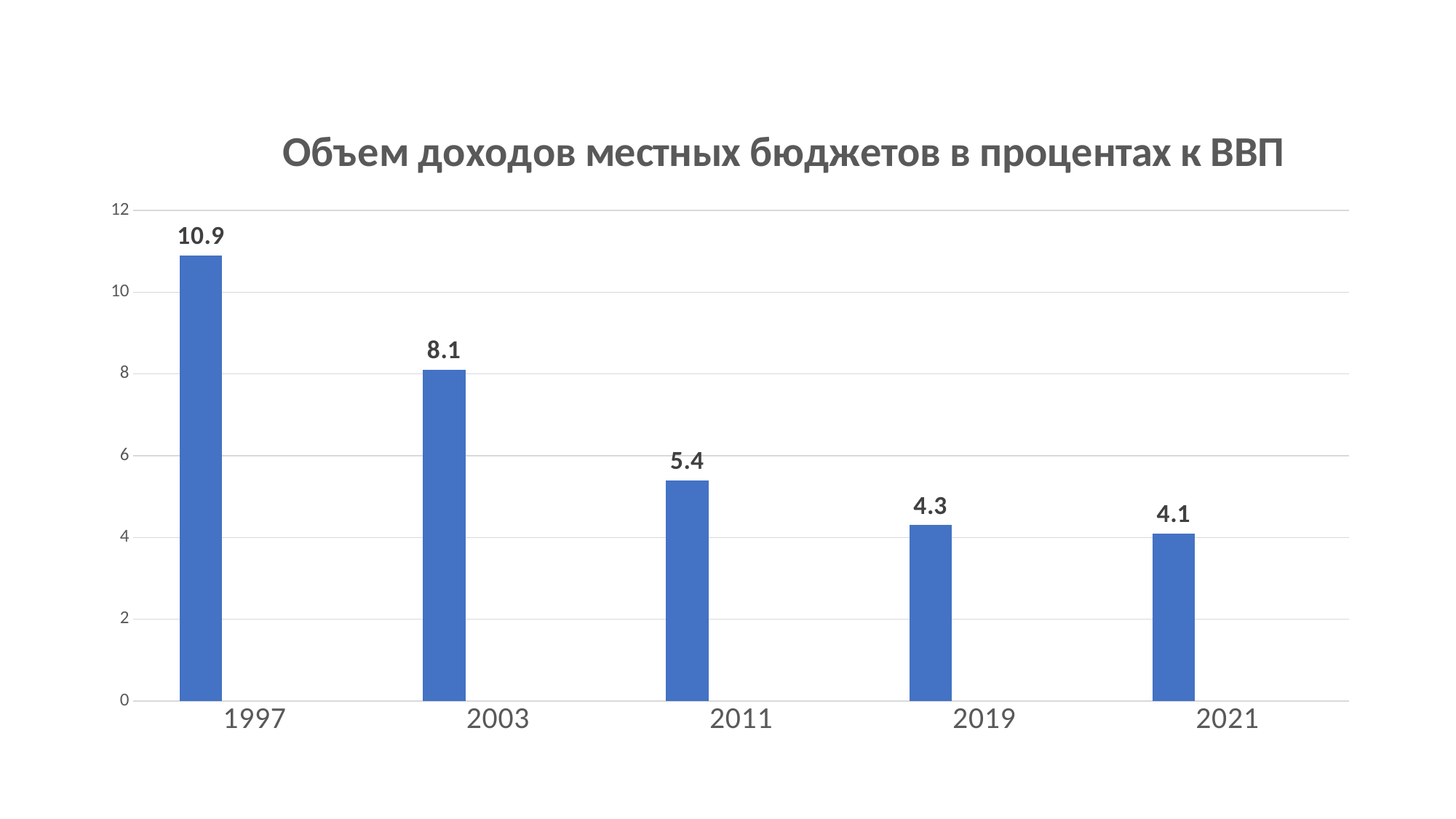
Which year has the highest value? 1997 Is the value for 2003 greater or less than 8? greater What is the value for 1997? 10.9 What is the difference between the values for 2011 and 2019? 1.1 What kind of chart is this? bar chart What is the value for 2021? 4.1 Which year has the lowest value? 2021 Do the values rise or fall from 1997 to 2021? fall How many years are shown on the x axis? 5 What is the value for 2011? 5.4 Which is larger, the value for 2003 or the value for 2011? 2003 What is the difference between the values for 1997 and 2003? 2.8